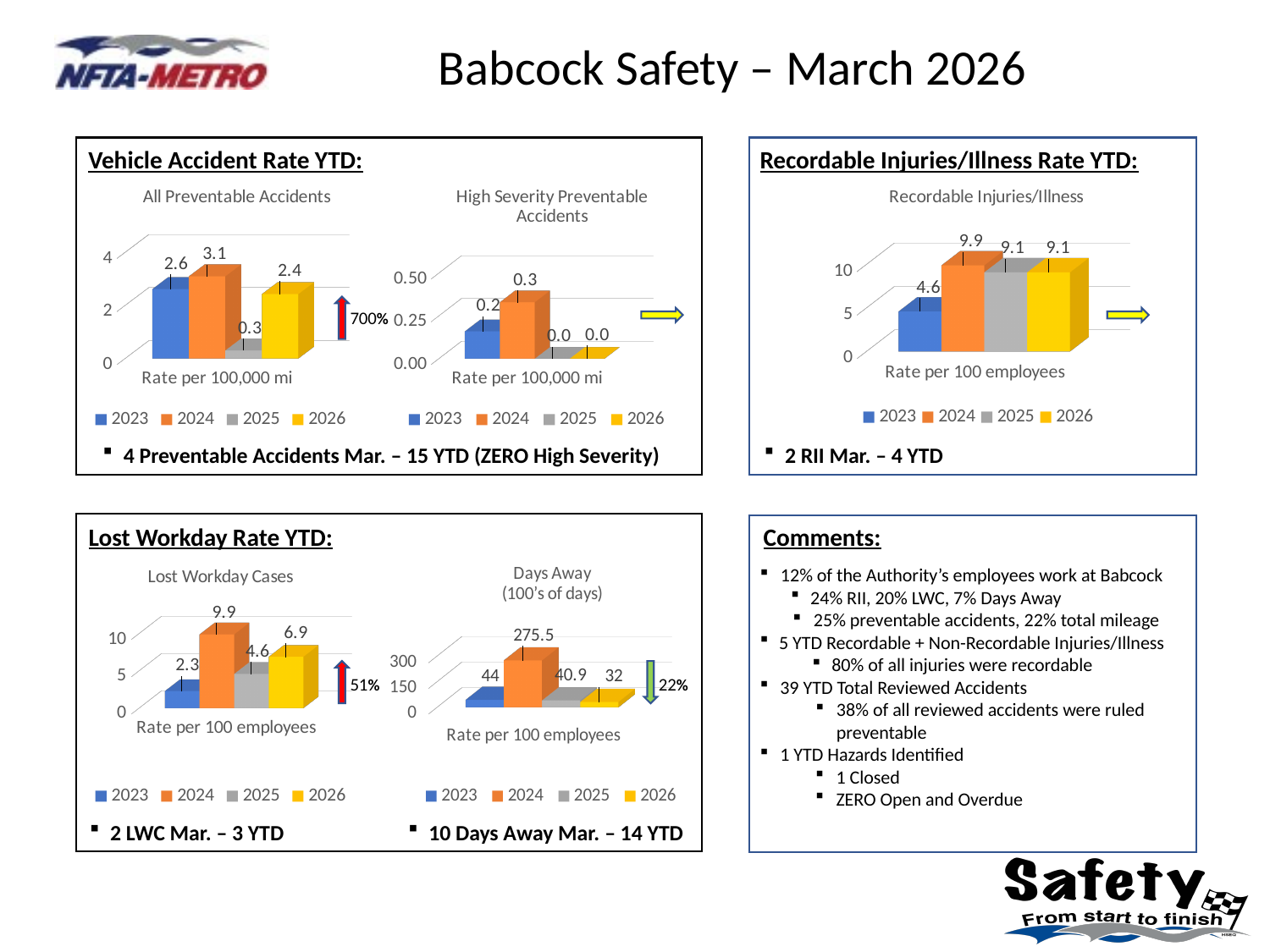
In the High Severity Preventable Accidents chart, what is the value for 2023? 0.2 In the Lost Workday Cases chart, what is the value for 2026? 6.9 What kind of chart is the Lost Workday Cases chart? Bar chart In the High Severity Preventable Accidents chart, how many series does the legend list? 4 In the Days Away (100's of days) chart, which year has the lowest value? 2026 In the Recordable Injuries/Illness chart, what is the x-axis category label? Rate per 100 employees In the Recordable Injuries/Illness chart, which year has the highest rate? 2024 In the Recordable Injuries/Illness chart, what is the difference between the 2024 and 2023 values? 5.3 In the All Preventable Accidents chart, what is the value for 2024? 3.1 In the Lost Workday Cases chart, which is larger, the value for 2025 or the value for 2026? 2026 In the Days Away (100's of days) chart, what is the value for 2024? 275.5 In the All Preventable Accidents chart, which year has the lowest rate? 2025